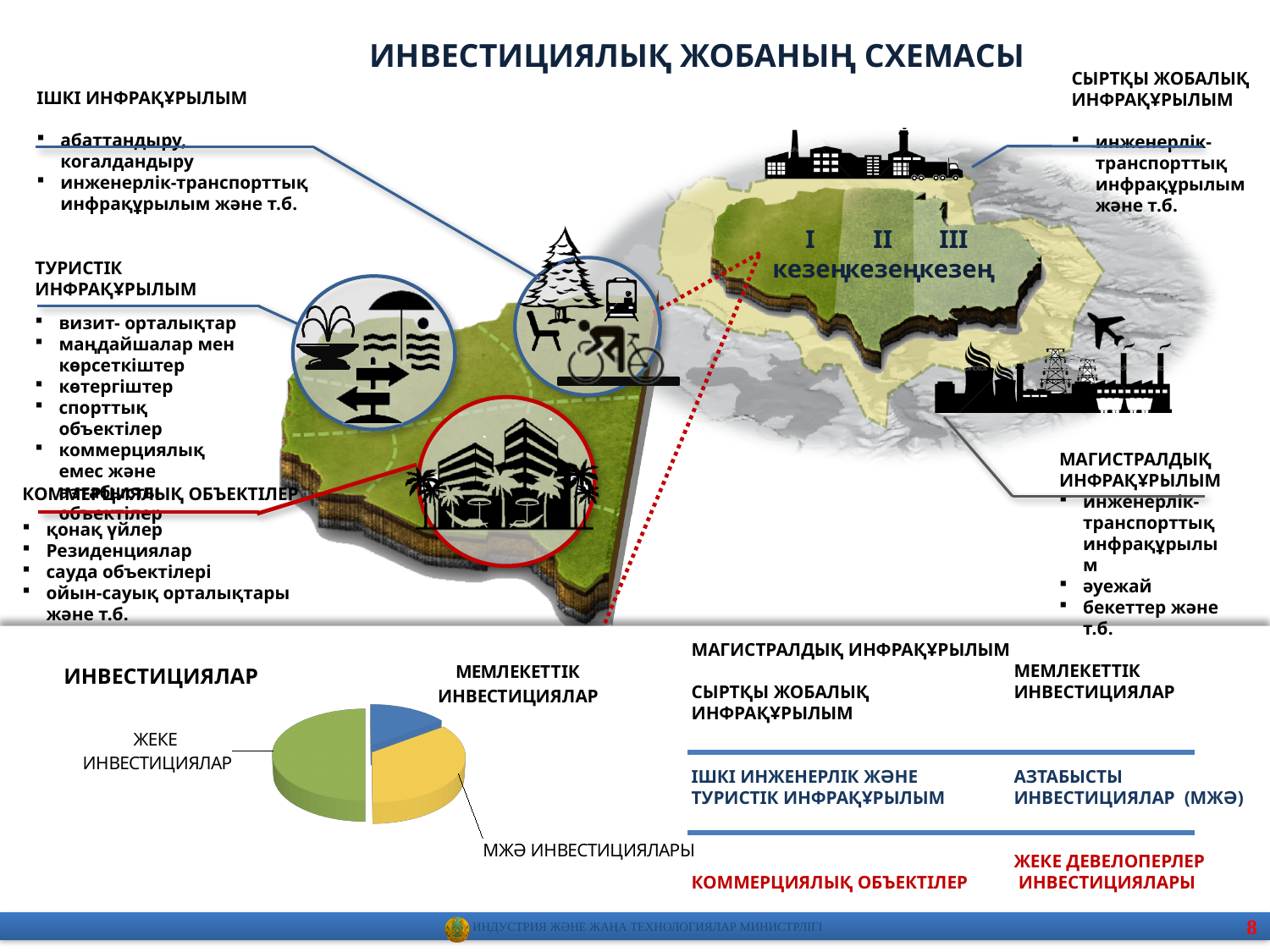
What kind of chart is shown under the heading ИНВЕСТИЦИЯЛАР? Pie chart How many slices does the ИНВЕСТИЦИЯЛАР pie chart have? 3 In the ИНВЕСТИЦИЯЛАР pie chart, which is larger: ЖЕКЕ ИНВЕСТИЦИЯЛАР or МЕМЛЕКЕТТІК ИНВЕСТИЦИЯЛАР? ЖЕКЕ ИНВЕСТИЦИЯЛАР What colour is the МЕМЛЕКЕТТІК ИНВЕСТИЦИЯЛАР slice in the pie chart? Blue What colour is the ЖЕКЕ ИНВЕСТИЦИЯЛАР slice in the pie chart? Green Which slice of the ИНВЕСТИЦИЯЛАР pie chart is the smallest? МЕМЛЕКЕТТІК ИНВЕСТИЦИЯЛАР In the ИНВЕСТИЦИЯЛАР pie chart, which is larger: МЖӘ ИНВЕСТИЦИЯЛАРЫ or МЕМЛЕКЕТТІК ИНВЕСТИЦИЯЛАР? МЖӘ ИНВЕСТИЦИЯЛАРЫ In the ИНВЕСТИЦИЯЛАР pie chart, which is larger: ЖЕКЕ ИНВЕСТИЦИЯЛАР or МЖӘ ИНВЕСТИЦИЯЛАРЫ? ЖЕКЕ ИНВЕСТИЦИЯЛАР Which slice of the ИНВЕСТИЦИЯЛАР pie chart is the largest? ЖЕКЕ ИНВЕСТИЦИЯЛАР